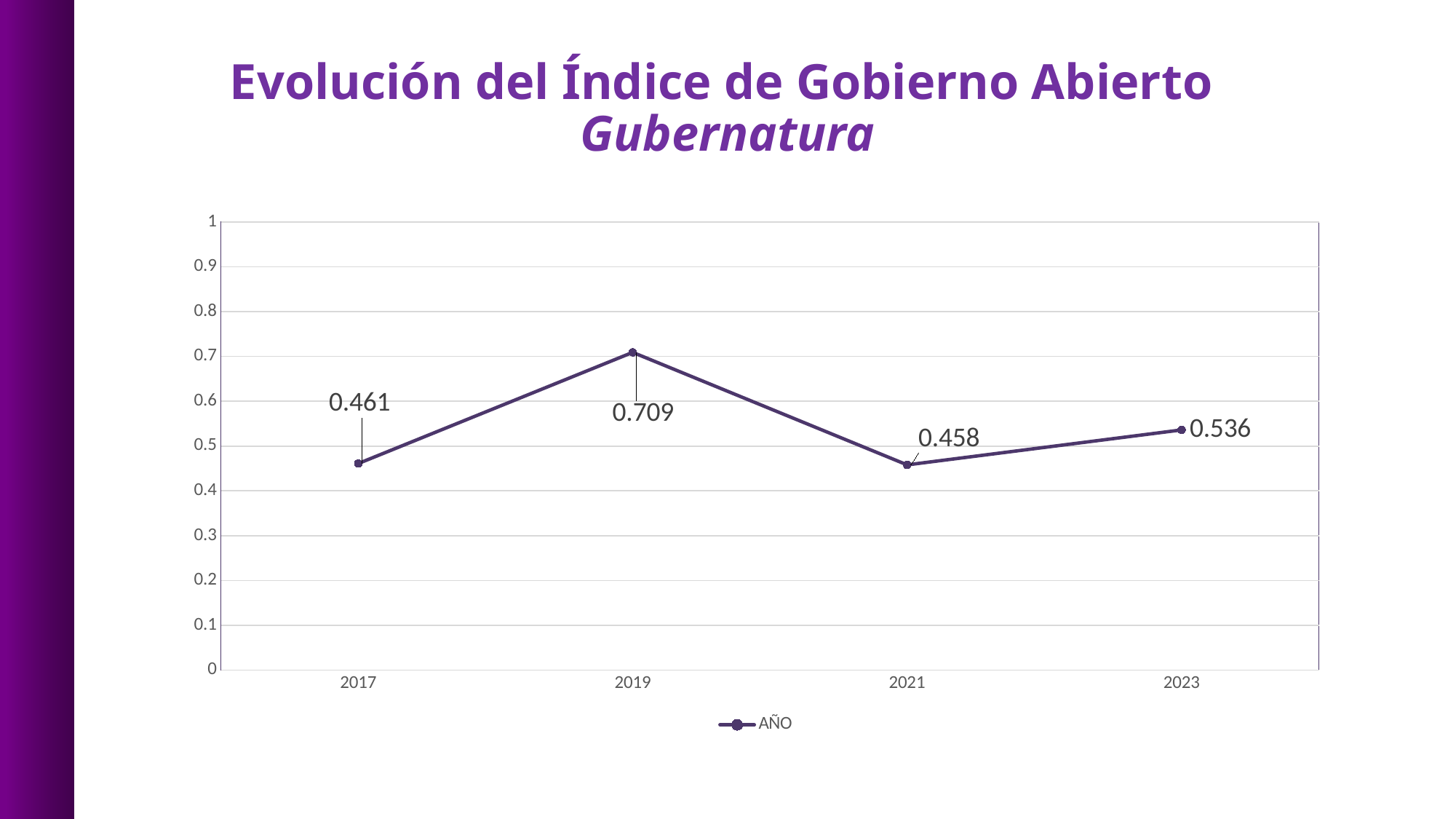
Which is larger, the value for 2023 or the value for 2017? 2023 Is the value for 2019 greater or less than 0.6? greater What is the value for 2021? 0.458 What is the difference between the values for 2019 and 2021? 0.251 Which year has the lowest value? 2021 What series name does the legend show? AÑO What is the value for 2017? 0.461 What is the value for 2023? 0.536 Which year has the highest value? 2019 How many years are plotted on the chart? 4 What is the value for 2019? 0.709 What kind of chart is shown on the slide? line chart